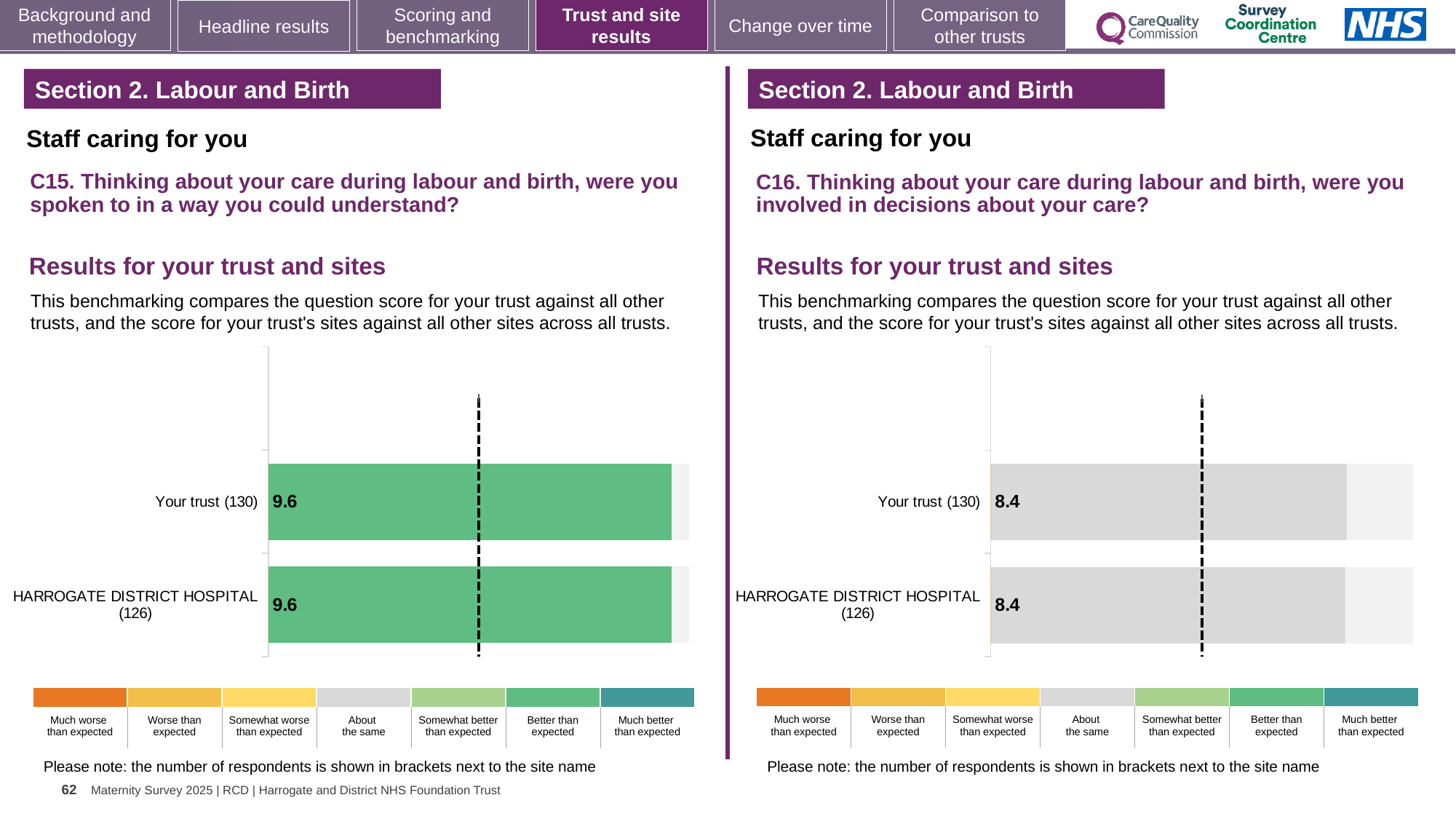
What type of chart is used for the C15 results on the left? Bar chart In the C16 chart on the right, what is the difference between the score for Your trust and the score for HARROGATE DISTRICT HOSPITAL? 0.0 In the C15 chart on the left, what is the difference between the score for Your trust and the score for HARROGATE DISTRICT HOSPITAL? 0.0 In the C15 chart on the left, what is the score for Your trust (130)? 9.6 How many bars are plotted in the C15 chart on the left? 2 How many bars are plotted in the C16 chart on the right? 2 In the C16 chart on the right, which benchmark category does the grey colour of the bars correspond to in the legend? About the same Is the Your trust score in the C15 chart on the left larger or smaller than the Your trust score in the C16 chart on the right? Larger In the C15 chart on the left, what is the score for HARROGATE DISTRICT HOSPITAL (126)? 9.6 In the C16 chart on the right, what is the score for Your trust (130)? 8.4 In the C15 chart on the left, which benchmark category does the green colour of the bars correspond to in the legend? Better than expected In the C16 chart on the right, what is the score for HARROGATE DISTRICT HOSPITAL (126)? 8.4